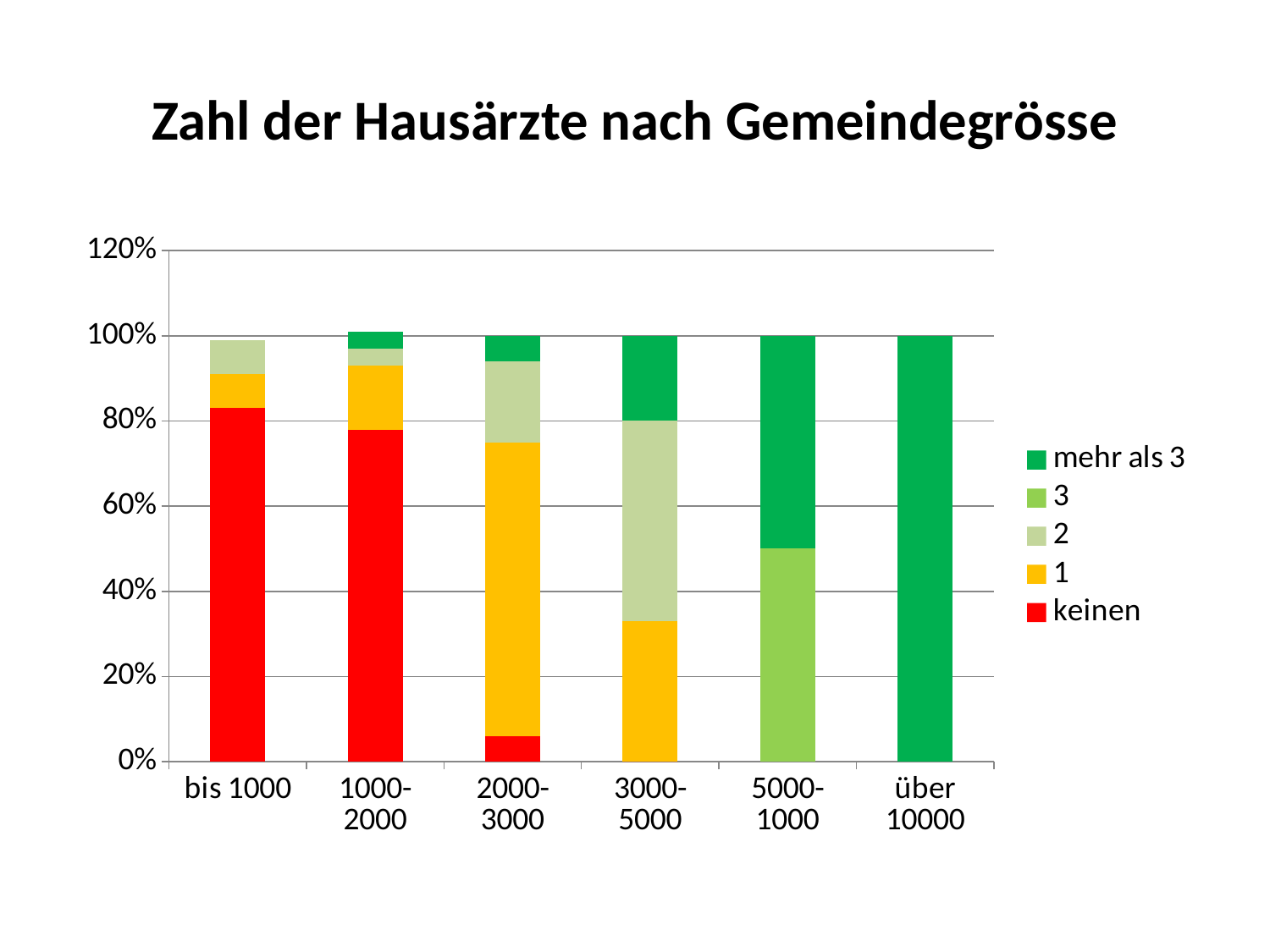
Is the value of "3" for "5000-1000" greater or less than 40%? greater How many series does the legend list? 5 What is the title of the chart? Zahl der Hausärzte nach Gemeindegrösse Is the value of "keinen" for "1000-2000" greater or less than 80%? less Which colour represents the series "keinen" in the legend? red What kind of chart is shown on the slide? stacked bar chart Does the "keinen" share rise or fall as the Gemeindegrösse increases along the x axis? fall How many categories (Gemeindegrösse groups) are shown on the x axis? 6 Is the value of "keinen" for "bis 1000" greater or less than 80%? greater Which category has the larger "keinen" value, "bis 1000" or "1000-2000"? bis 1000